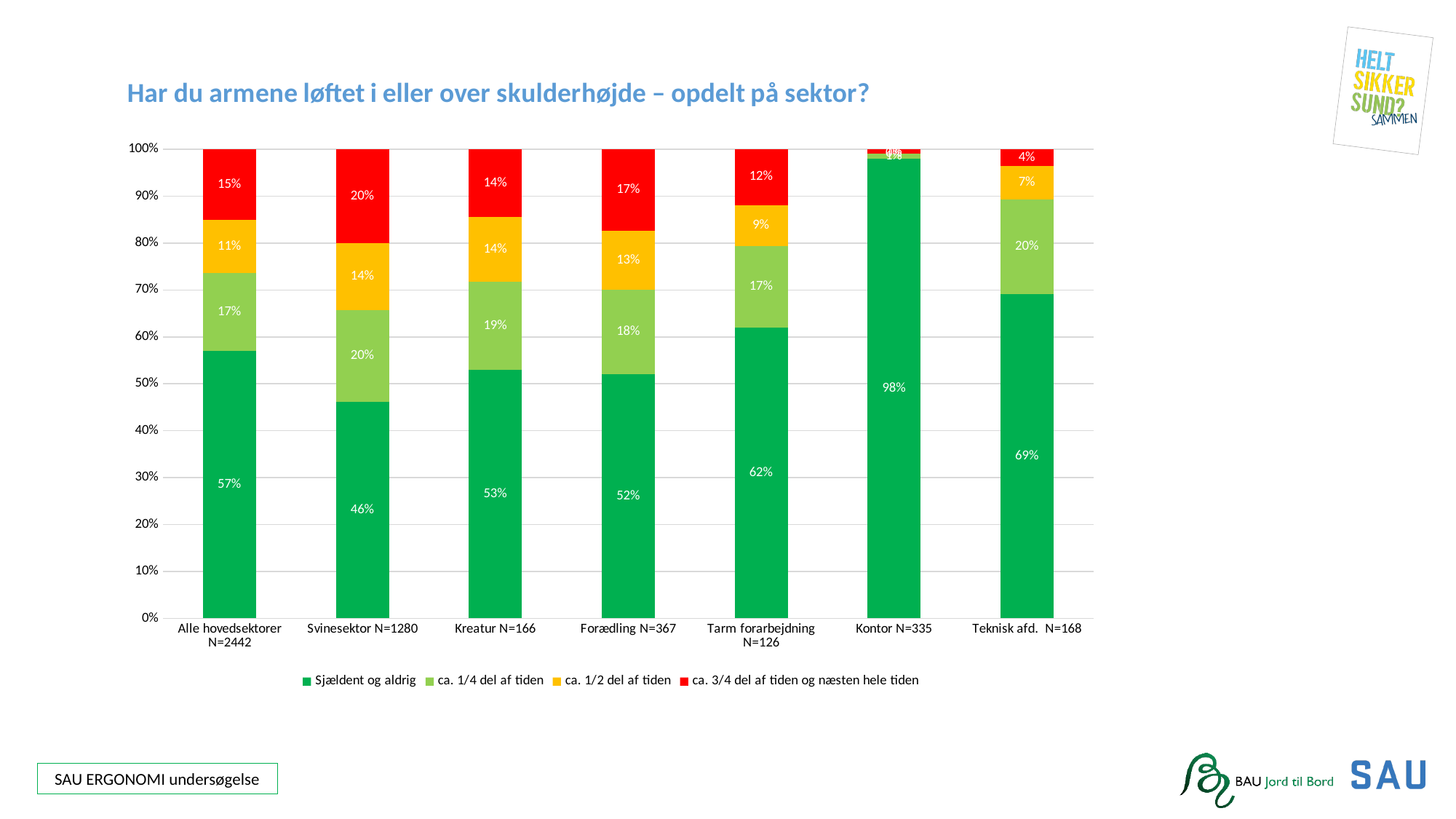
What type of chart is shown on the slide? Stacked bar chart How many sectors (categories) are shown on the x axis? 7 What is the 'ca. 3/4 del af tiden og næsten hele tiden' value for Forædling N=367? 17% Which series is shown in red in the legend? ca. 3/4 del af tiden og næsten hele tiden Which is larger: the 'ca. 3/4 del af tiden og næsten hele tiden' value for Svinesektor N=1280 or for Kreatur N=166? Svinesektor N=1280 How many series does the legend list? 4 What is the difference between the 'Sjældent og aldrig' values for Teknisk afd. N=168 and Alle hovedsektorer N=2442? 12% What is the 'Sjældent og aldrig' value for Svinesektor N=1280? 46% Which sector has the highest 'Sjældent og aldrig' value? Kontor N=335 What is the 'ca. 1/4 del af tiden' value for Teknisk afd. N=168? 20% What is the 'ca. 1/2 del af tiden' value for Tarm forarbejdning N=126? 9% Which sector has the lowest 'Sjældent og aldrig' value? Svinesektor N=1280